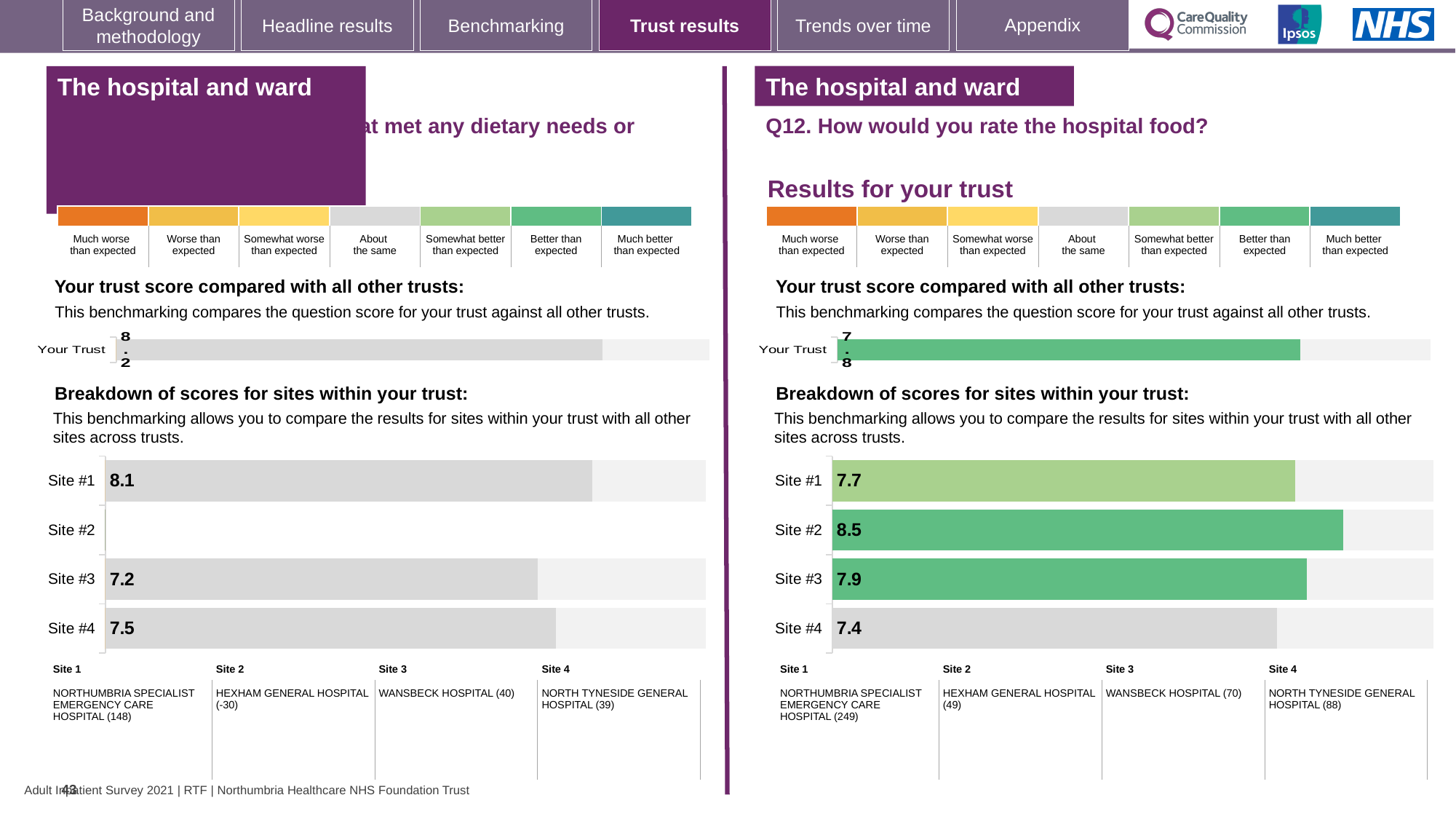
In the right-hand 'Breakdown of scores for sites within your trust' chart (Q12), what is the score for Site #2? 8.5 In the left-hand 'Breakdown of scores for sites within your trust' chart, what is the score for Site #1? 8.1 In the right-hand 'Breakdown of scores for sites within your trust' chart (Q12), what is the difference between the scores for Site #2 and Site #4? 1.1 In the left-hand 'Breakdown of scores for sites within your trust' chart, which of the labelled sites has the lowest score? Site #3 In the right-hand 'Breakdown of scores for sites within your trust' chart (Q12), which is larger: the score for Site #1 or Site #3? Site #3 In the left-hand 'Breakdown of scores for sites within your trust' chart, what is the difference between the scores for Site #1 and Site #3? 0.9 On the right-hand slide section (Q12. How would you rate the hospital food?), what is the trust score shown in the 'Your trust score compared with all other trusts' bar chart? 7.8 In the right-hand 'Breakdown of scores for sites within your trust' chart (Q12), which site has the lowest score? Site #4 In the right-hand 'Breakdown of scores for sites within your trust' chart (Q12), which site has the highest score? Site #2 On the left-hand slide section, what is the trust score shown in the 'Your trust score compared with all other trusts' bar chart? 8.2 What kind of chart is used for the 'Breakdown of scores for sites within your trust' on the right-hand section? Bar chart In the right-hand 'Breakdown of scores for sites within your trust' chart (Q12), how many sites are listed? 4